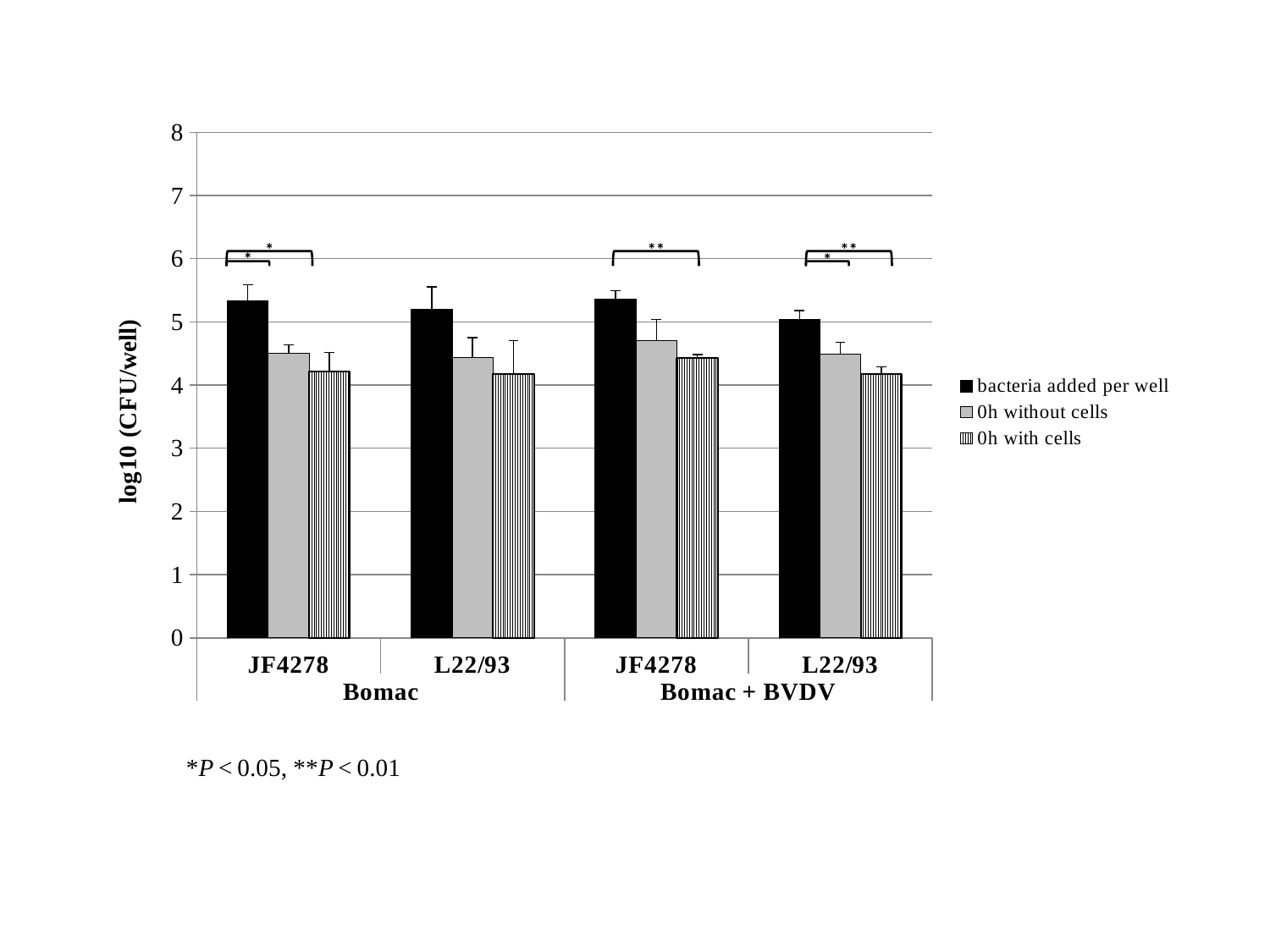
Which series is drawn with solid black bars? bacteria added per well What is the label of the y axis? log10 (CFU/well) Is the value for 'bacteria added per well' for JF4278 under Bomac greater or less than 5? greater Is the value for '0h without cells' for JF4278 under Bomac + BVDV greater or less than 4? greater Is the value for '0h with cells' for L22/93 under Bomac + BVDV greater or less than 5? less How many category groups are shown along the x axis? 4 For JF4278 under Bomac + BVDV, which is larger: 'bacteria added per well' or '0h with cells'? bacteria added per well For L22/93 under Bomac + BVDV, which is larger: 'bacteria added per well' or '0h without cells'? bacteria added per well For JF4278 under Bomac + BVDV, which is larger: '0h without cells' or '0h with cells'? 0h without cells How many series does the legend list? 3 What kind of chart is shown on the slide? bar chart